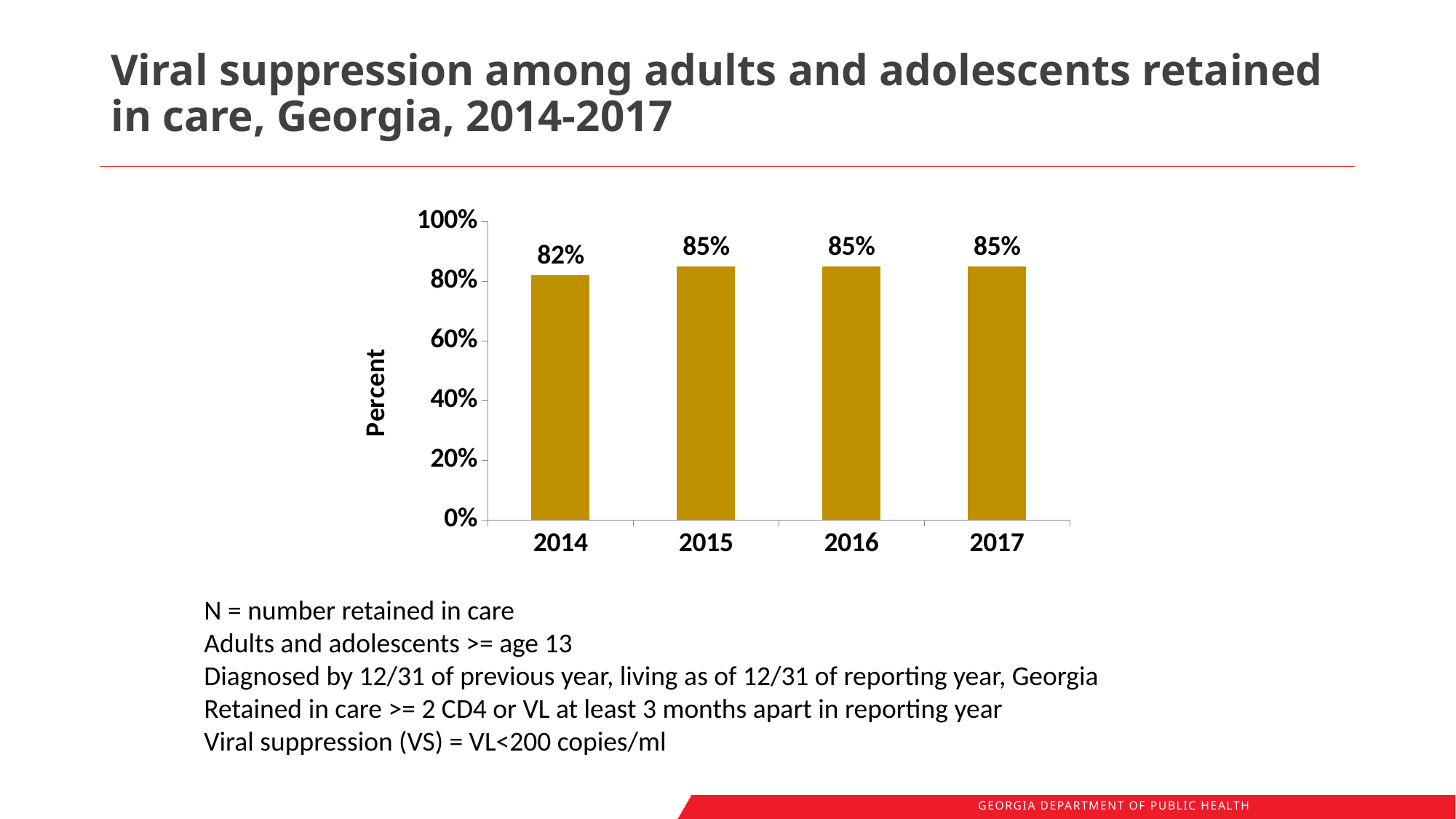
Which year has the lowest viral suppression percentage? 2014 How many years are shown on the x axis? 4 What is the viral suppression percentage for 2015? 85% What is the viral suppression percentage for 2017? 85% What is the viral suppression percentage for 2014? 82% Do the values rise or fall from 2014 to 2015? rise What colour are the bars in the chart? gold Is the value for 2014 greater or less than 80%? greater What is the difference in viral suppression percentage between 2015 and 2014? 3% What is the label of the y axis? Percent What kind of chart is shown on the slide? bar chart Which is larger, the value for 2014 or the value for 2016? 2016